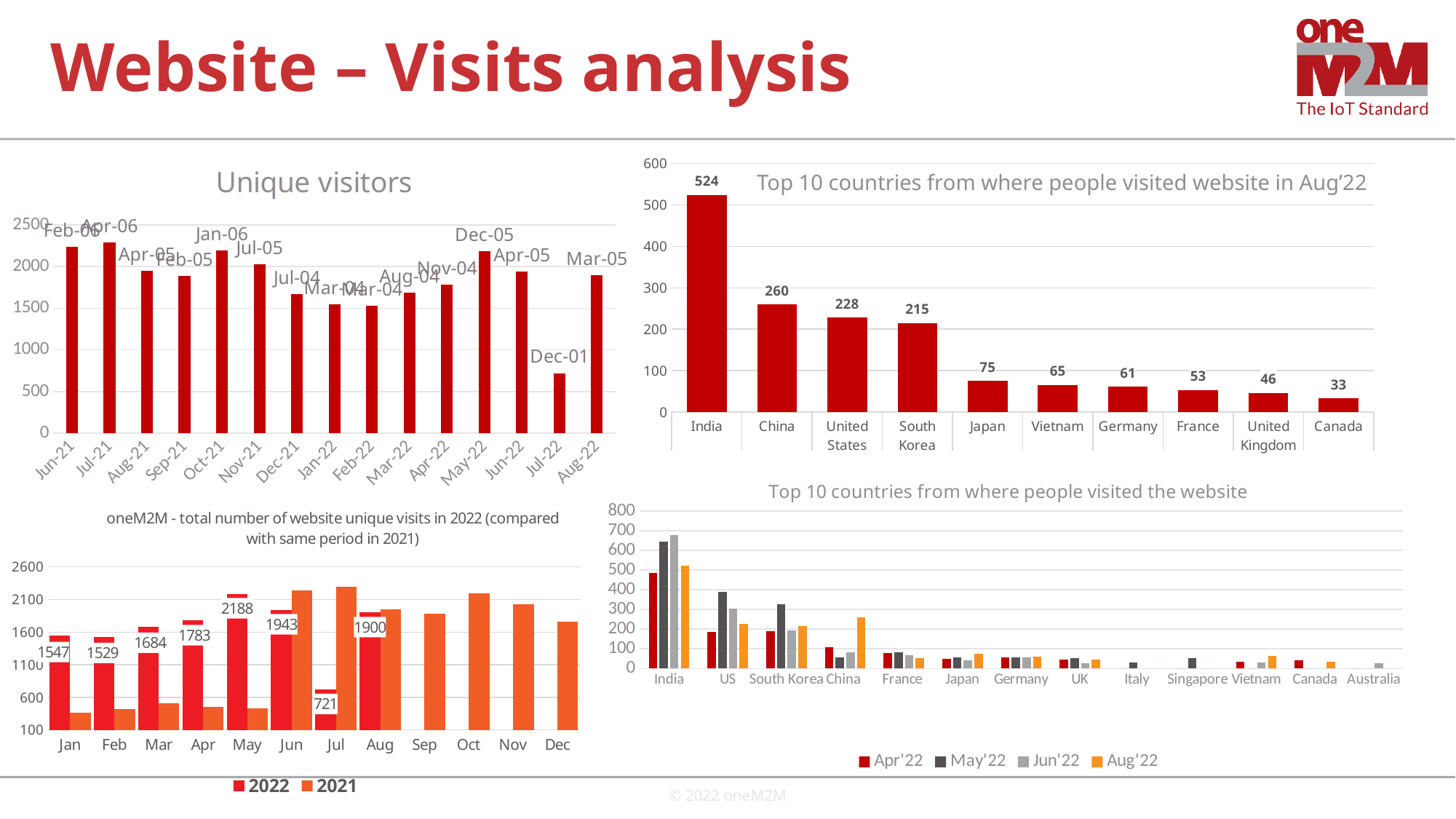
In the 'Top 10 countries from where people visited website in Aug'22' chart, what is the difference between the values for China and United States? 32 In the 'Top 10 countries from where people visited website in Aug'22' chart, which country has the lowest value? Canada In the 'Top 10 countries from where people visited the website' chart at the bottom right, how many series does the legend list? 4 In the 'Top 10 countries from where people visited website in Aug'22' chart, how many countries are shown? 10 In the 'Unique visitors' chart, is the value for Jul-22 greater or less than 1000? less In the 'Unique visitors' chart, which month has the lowest bar? Jul-22 In the 'Top 10 countries from where people visited website in Aug'22' chart, what is the value for India? 524 In the 'oneM2M - total number of website unique visits in 2022' chart, what is the 2022 value for May? 2188 In the 'Top 10 countries from where people visited website in Aug'22' chart, which is larger, the value for Vietnam or the value for Germany? Vietnam In the 'oneM2M - total number of website unique visits in 2022' chart, which month has the lowest labelled 2022 value? Jul In the 'oneM2M - total number of website unique visits in 2022' chart, how many series does the legend list? 2 In the 'oneM2M - total number of website unique visits in 2022' chart, what is the difference between the 2022 values for Jun and Jul? 1222